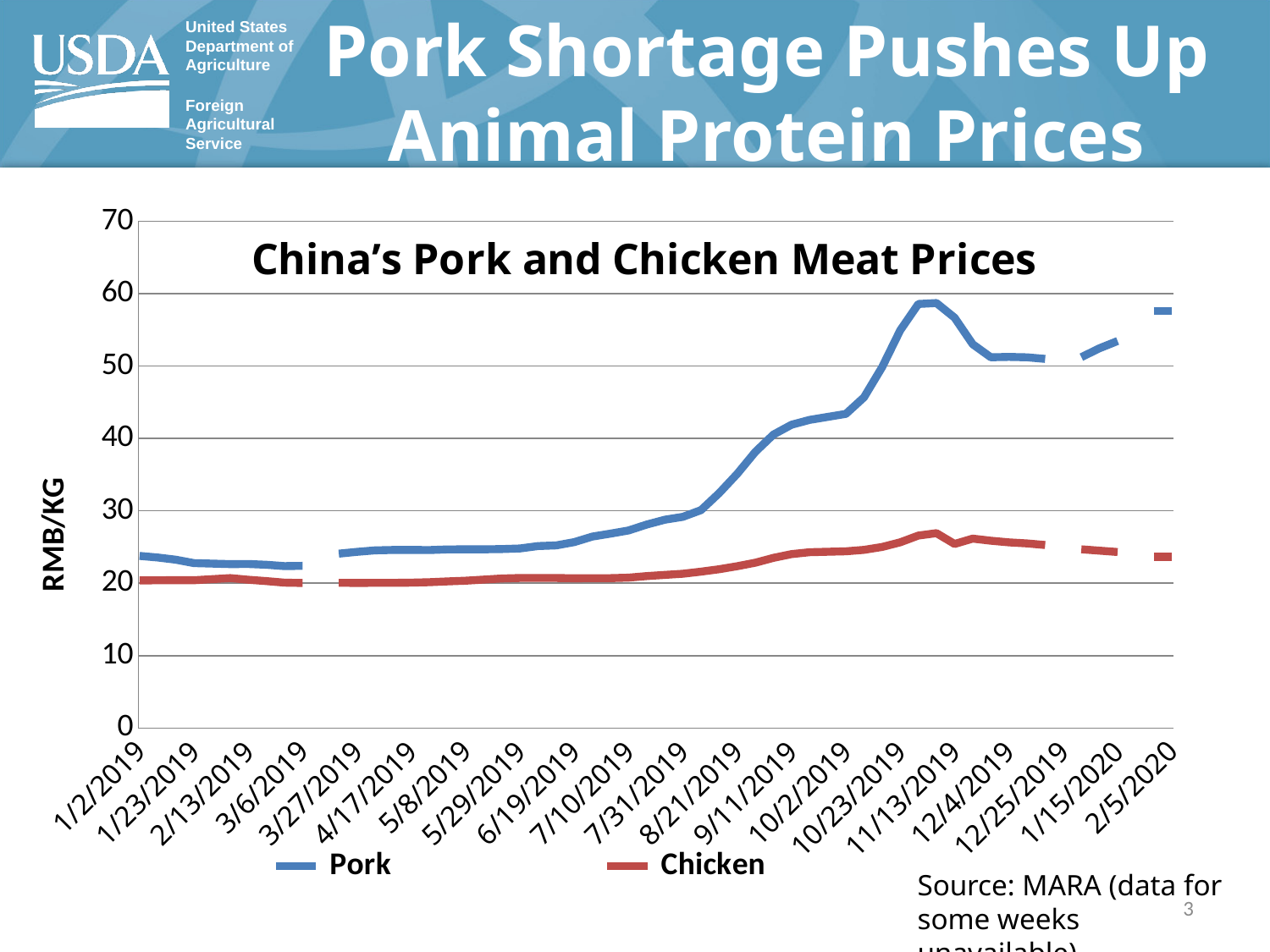
Is the value for Pork on 1/2/2019 greater or less than 30? less Is the value for Pork on 11/13/2019 greater or less than 50? greater Which series has the higher value on 11/13/2019, Pork or Chicken? Pork How many series does the legend list? 2 What is the label on the vertical axis? RMB/KG What kind of chart is shown on the slide? line chart Is the Pork value higher on 2/5/2020 or on 1/2/2019? 2/5/2020 Is the value for Chicken on 11/13/2019 greater or less than 30? less What is the title of the chart? China's Pork and Chicken Meat Prices Overall, does the Pork price rise or fall from 1/2/2019 to 2/5/2020? rise